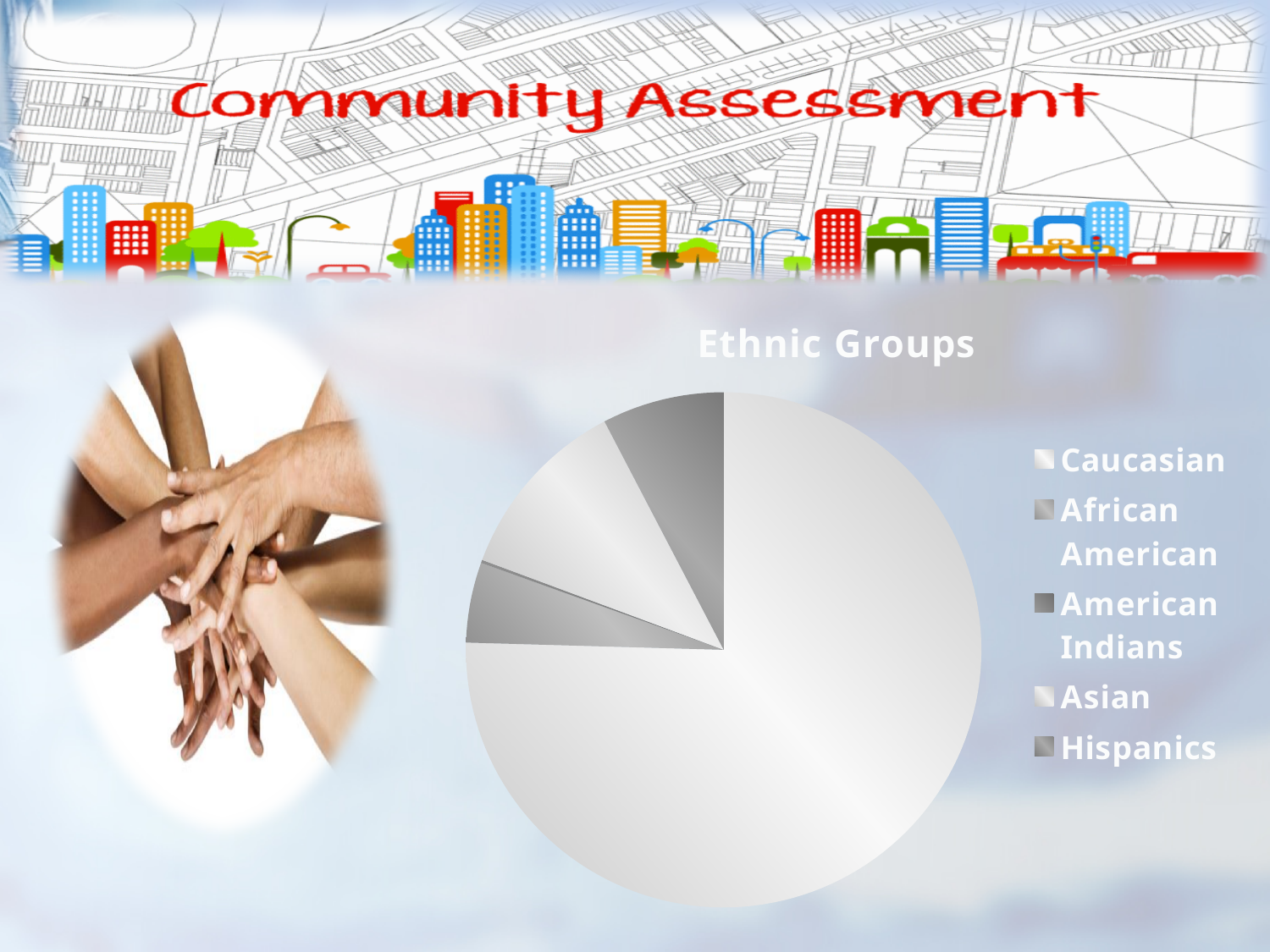
Which ethnic group has the largest slice of the pie? Caucasian How many data series does the pie chart plot? 1 Which is larger, the slice for African American or the slice for Caucasian? Caucasian Which is larger, the slice for Caucasian or the slice for Asian? Caucasian Which is larger, the slice for Caucasian or the slice for Hispanics? Caucasian What kind of chart is shown on the slide? Pie chart Which ethnic group is listed first in the legend? Caucasian How many ethnic groups (categories) does the pie chart show? 5 What is the title of the chart? Ethnic Groups